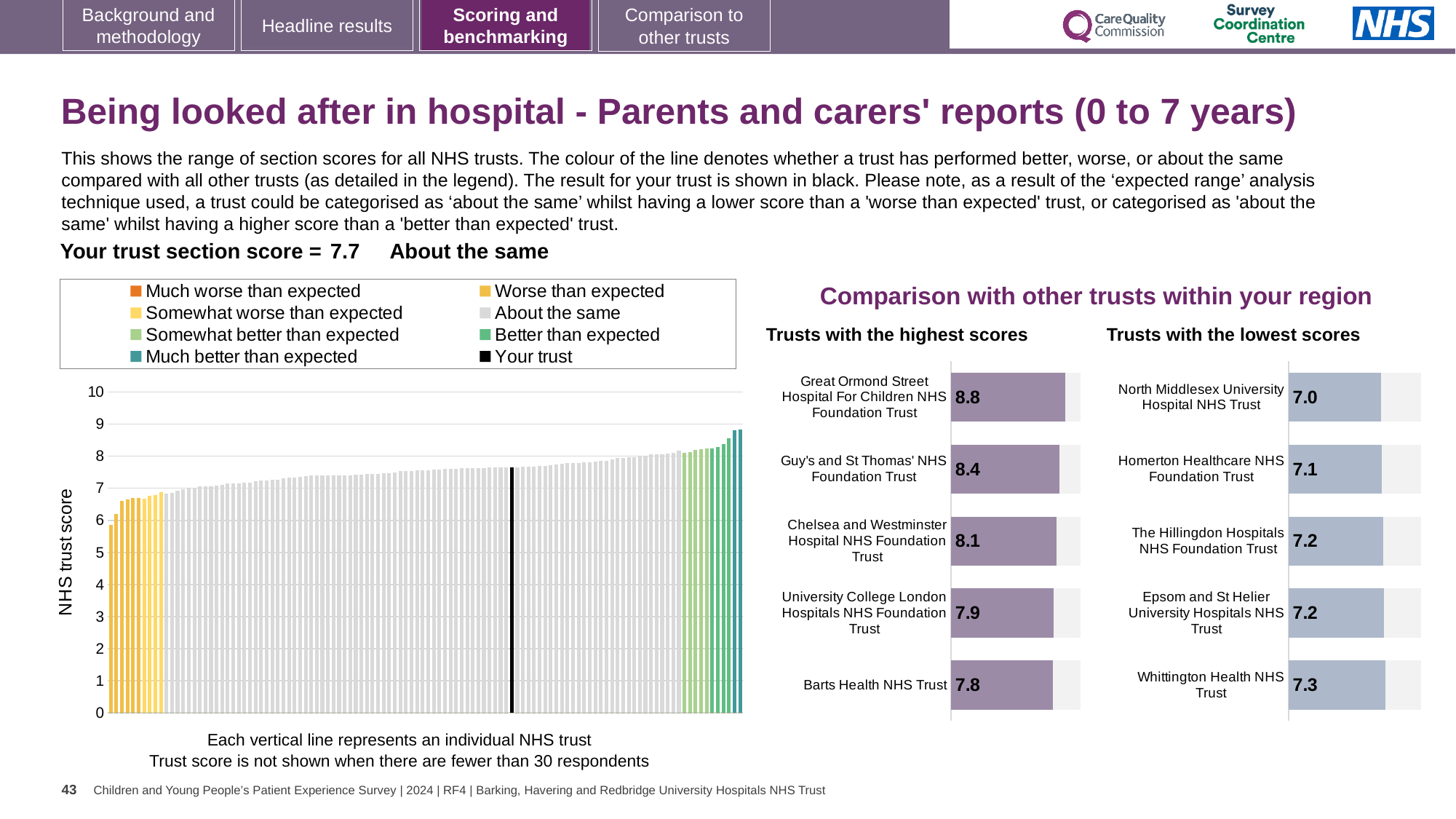
What kind of chart is the NHS trust score chart on the left of the slide? Bar chart In the 'Trusts with the lowest scores' chart, what is the score for Whittington Health NHS Trust? 7.3 In the 'Trusts with the lowest scores' chart, which trust has the lowest score? North Middlesex University Hospital NHS Trust How many trusts are shown in the 'Trusts with the highest scores' chart? 5 In the 'Trusts with the highest scores' chart, what is the difference between the scores of Great Ormond Street Hospital For Children NHS Foundation Trust and Barts Health NHS Trust? 1.0 What is the title of the section containing the two bar charts on the right of the slide? Comparison with other trusts within your region In the 'Trusts with the lowest scores' chart, which has the higher score: Homerton Healthcare NHS Foundation Trust or The Hillingdon Hospitals NHS Foundation Trust? The Hillingdon Hospitals NHS Foundation Trust In the NHS trust score chart on the left, is the value of the black 'Your trust' bar greater or less than 7? greater In the 'Trusts with the highest scores' chart, which trust has the highest score? Great Ormond Street Hospital For Children NHS Foundation Trust In the NHS trust score chart on the left, do the values rise or fall from left to right along the x axis? Rise In the 'Trusts with the highest scores' chart, what is the score for Great Ormond Street Hospital For Children NHS Foundation Trust? 8.8 How many entries does the legend of the NHS trust score chart on the left list? 8